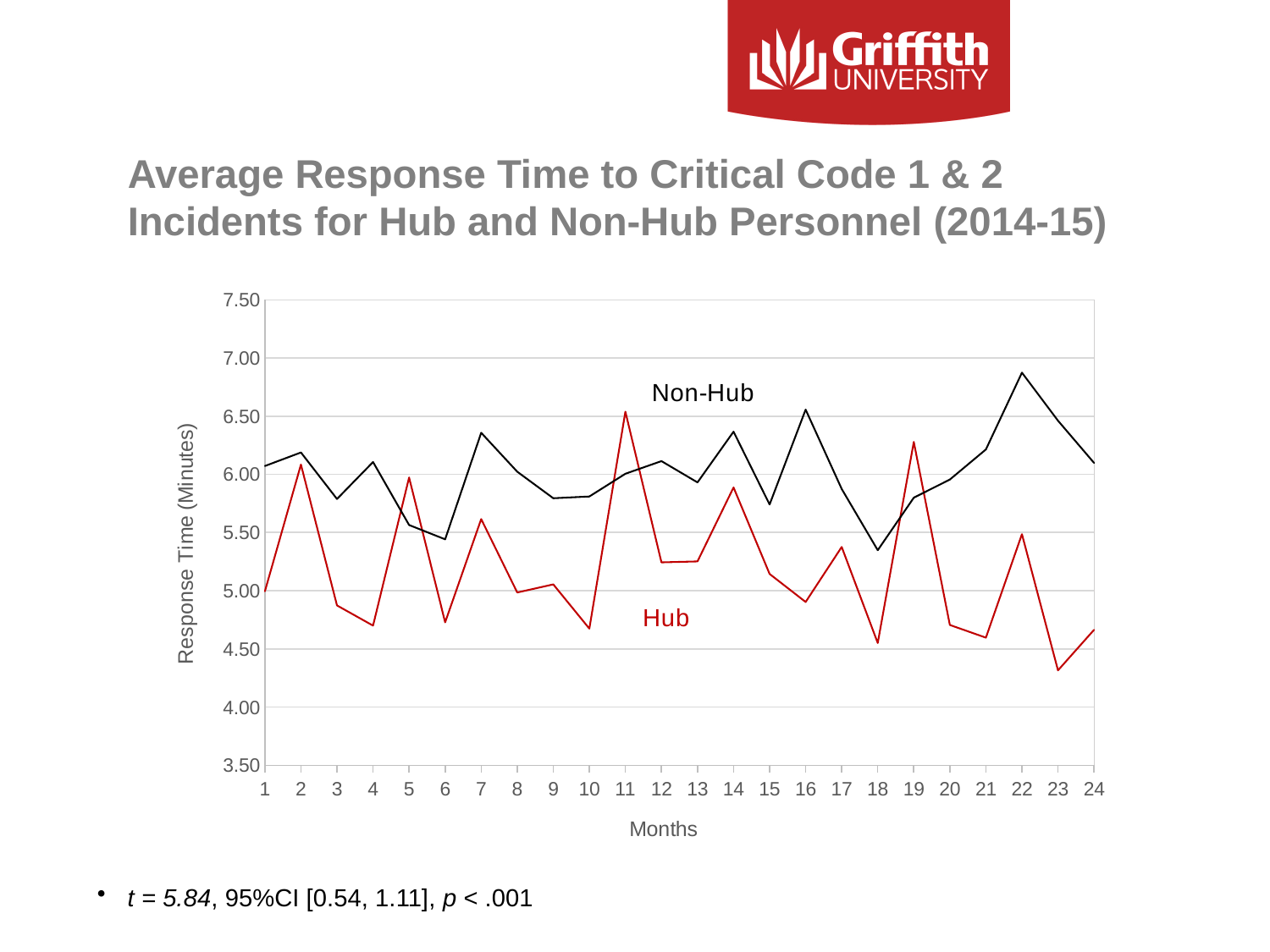
How many months are plotted along the x axis? 24 Is the Hub value at month 23 greater or less than 4.50? less Is the Non-Hub value at month 22 greater or less than 6.50? greater What is the label on the vertical axis? Response Time (Minutes) Is the Non-Hub value at month 18 greater or less than 5.50? less At month 11, which series has the higher response time, Hub or Non-Hub? Hub How many series are plotted on the chart? 2 In which month does the Hub series reach its highest response time? 11 What kind of chart is shown on the slide? Line chart In which month does the Non-Hub series reach its highest response time? 22 In which month does the Hub series reach its lowest response time? 23